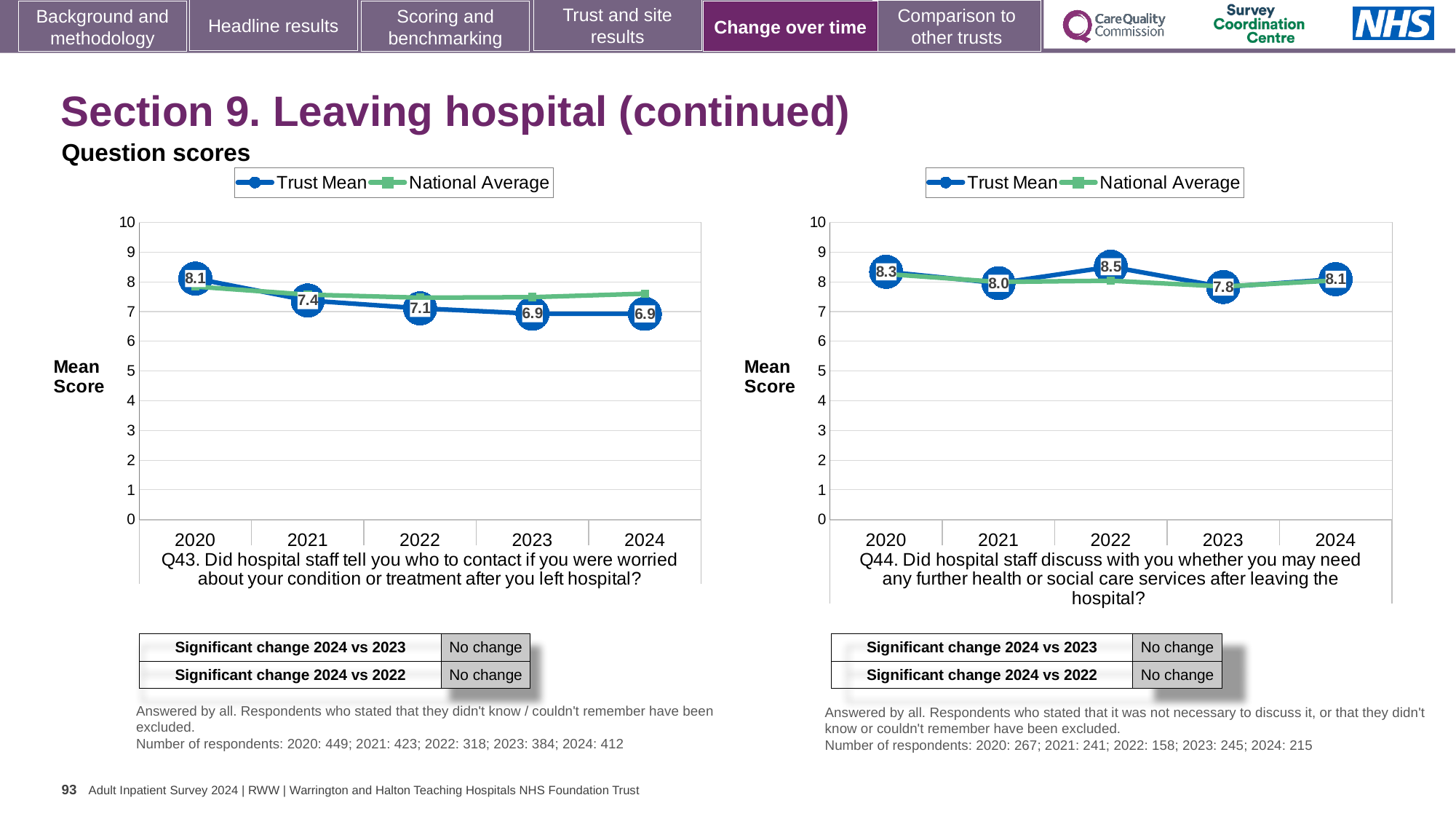
In the left chart (Q43), which year has the highest Trust Mean score? 2020 In the right chart (Q44), what is the Trust Mean score for 2023? 7.8 What kind of chart is the left chart (Q43)? Line chart In the left chart (Q43), what is the Trust Mean score for 2020? 8.1 How many series does the legend of the left chart (Q43) list? 2 How many years are plotted on the x axis of the right chart (Q44)? 5 In the left chart (Q43), what is the Trust Mean score for 2024? 6.9 In the left chart (Q43), what is the difference between the Trust Mean scores for 2020 and 2024? 1.2 In the right chart (Q44), which year has the lowest Trust Mean score? 2023 In the right chart (Q44), what is the Trust Mean score for 2022? 8.5 In the right chart (Q44), which is larger, the Trust Mean score for 2021 or for 2022? 2022 In the left chart (Q43), is the National Average for 2024 greater or less than 7? greater